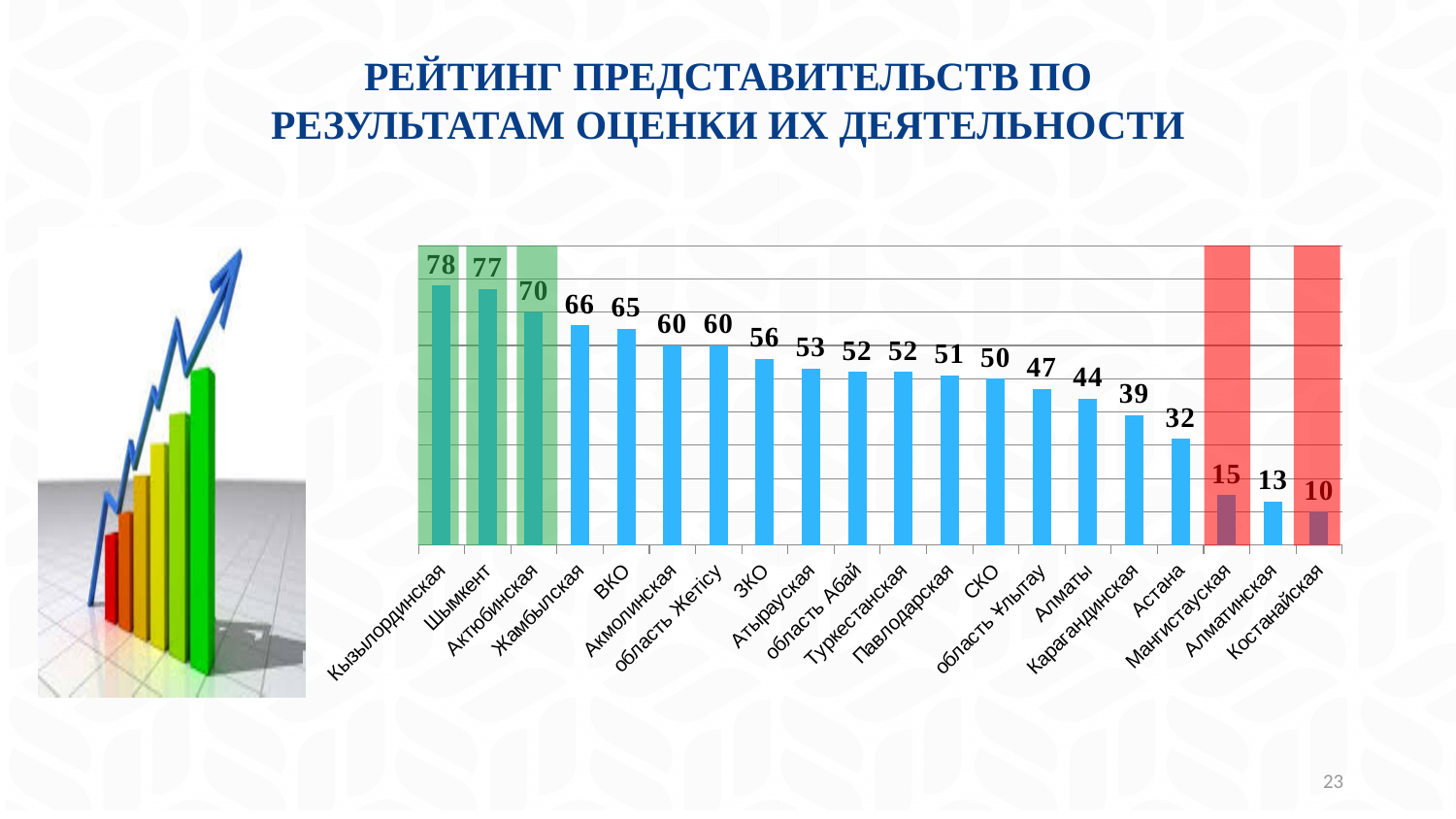
What is the difference between the values for Кызылординская and Костанайская? 68 What is the value for область Ұлытау? 47 Which is larger, the value for Мангистауская or the value for Алматинская? Мангистауская What is the value for Кызылординская? 78 What is the value for Астана? 32 Which category has the highest value? Кызылординская What kind of chart is shown on the slide? Bar chart Which is larger, the value for Алматы or the value for Карагандинская? Алматы Do the values rise or fall from left to right along the x axis? Fall What is the difference between the values for Шымкент and Актюбинская? 7 Which category has the lowest value? Костанайская How many categories are shown on the chart? 20